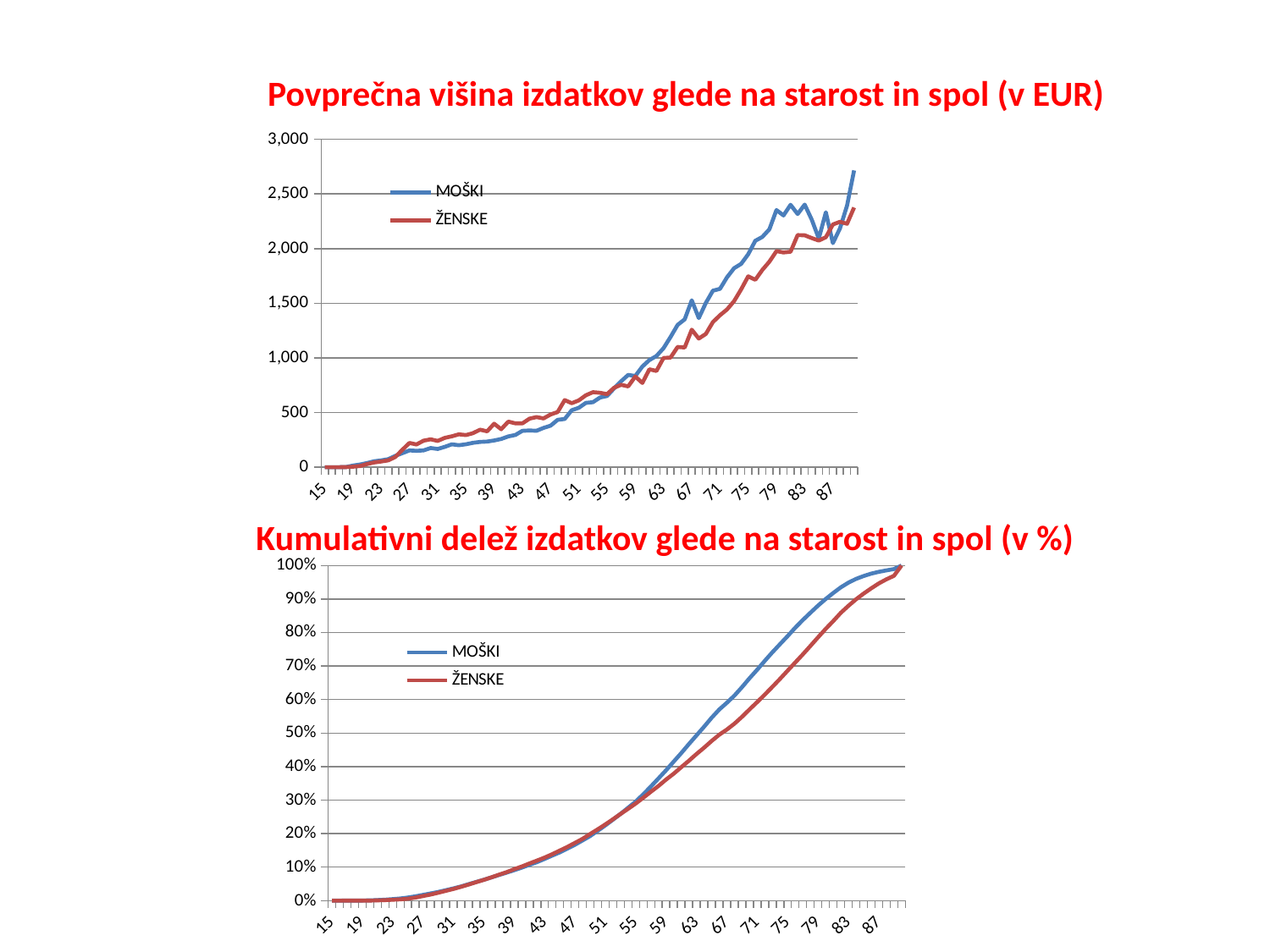
What kind of chart is the bottom chart, 'Kumulativni delež izdatkov glede na starost in spol (v %)'? line chart In the bottom chart, at age 75, which series has the higher cumulative share, MOŠKI or ŽENSKE? MOŠKI How many series does the legend of the top chart list? 2 In the top chart, is the MOŠKI value at age 79 greater or less than 2,000? greater In the bottom chart, do the cumulative shares rise or fall as age increases along the x axis? rise What kind of chart is the top chart, 'Povprečna višina izdatkov glede na starost in spol (v EUR)'? line chart In the top chart, is the ŽENSKE value at age 35 greater or less than 500? less In the top chart, which colour is the MOŠKI line? blue In the top chart, at age 75, which series has the higher value, MOŠKI or ŽENSKE? MOŠKI In the top chart, do the values generally rise or fall as age increases along the x axis? rise What are the two series named in the legend of the bottom chart? MOŠKI and ŽENSKE In the bottom chart, is the MOŠKI cumulative share at age 71 greater or less than 60%? greater